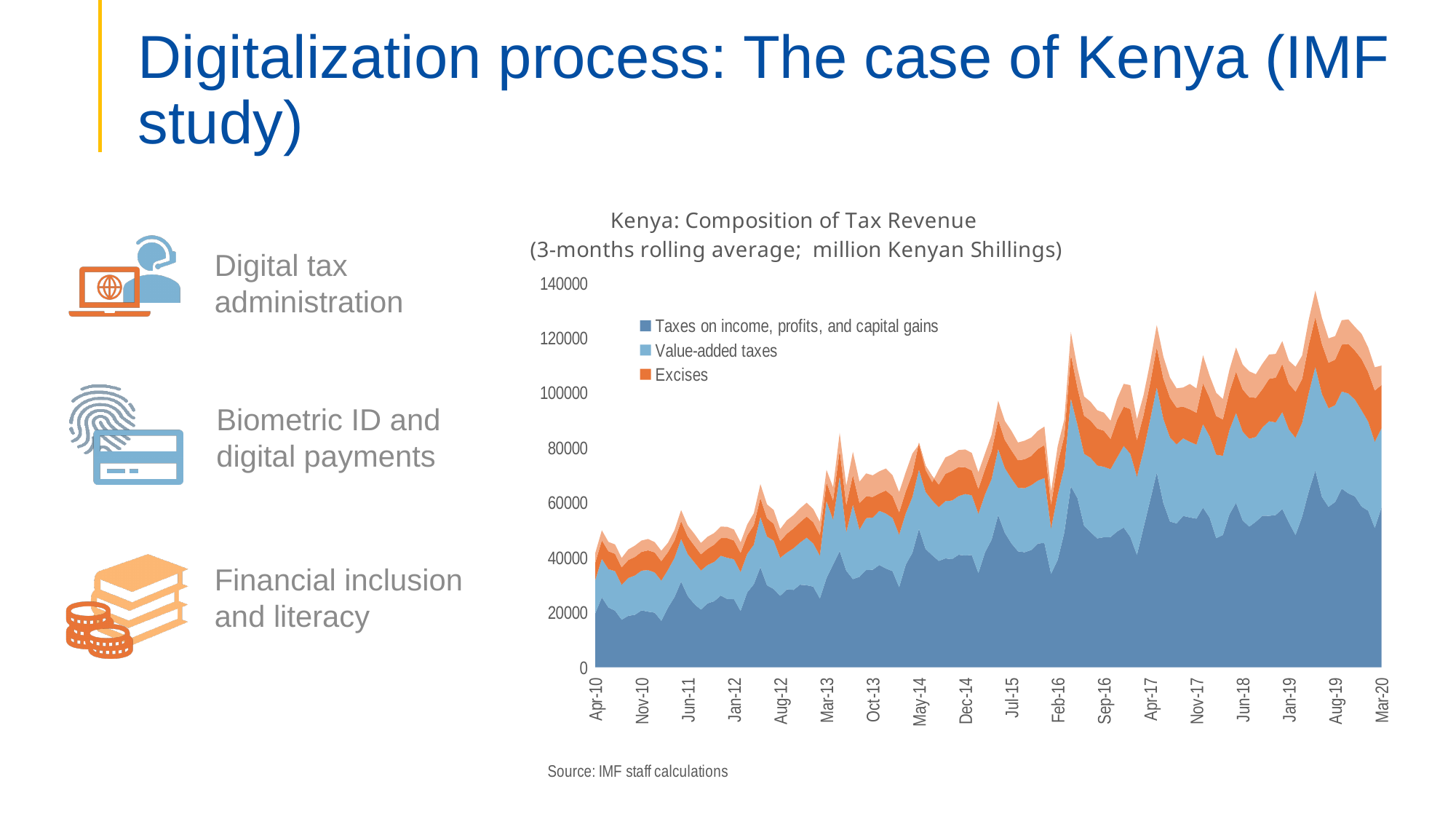
Does total tax revenue generally rise or fall from Apr-10 to Mar-20? Rise Is the total tax revenue at Mar-20 greater or less than 100000? greater Is the total tax revenue at Apr-10 greater or less than 60000? less Which series contributes the largest share of tax revenue throughout the period: Taxes on income, profits, and capital gains or Excises? Taxes on income, profits, and capital gains What is the title of the chart? Kenya: Composition of Tax Revenue Is the total tax revenue at Jan-12 greater or less than 80000? less What is the highest value shown on the vertical axis? 140000 Which series is shown in the darkest blue at the bottom of the chart? Taxes on income, profits, and capital gains What kind of chart is shown on the slide? Stacked area chart How many series does the chart's legend list? 3 At Mar-20, which is larger: Value-added taxes or Excises? Value-added taxes